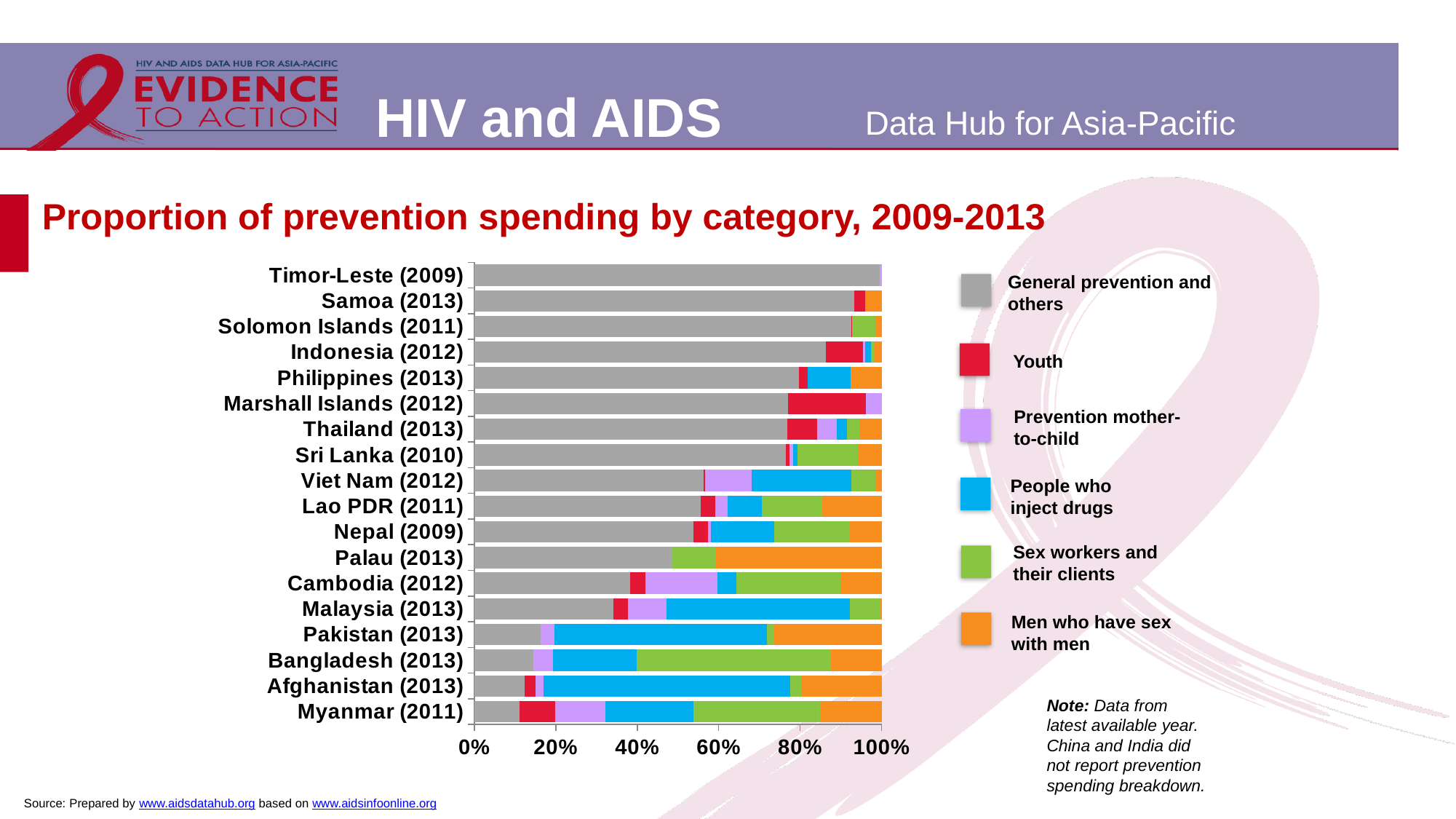
Which country has the smallest share of spending on 'General prevention and others'? Myanmar (2011) What is the title of the chart? Proportion of prevention spending by category, 2009-2013 Which has a larger 'General prevention and others' share, Palau (2013) or Cambodia (2012)? Palau (2013) Is the 'People who inject drugs' share for Afghanistan (2013) greater or less than 40%? greater Is the 'General prevention and others' share for Myanmar (2011) greater or less than 20%? less How many spending categories does the legend list? 6 What kind of chart is shown on the slide? Stacked bar chart Is the 'General prevention and others' share for Timor-Leste (2009) greater or less than 80%? greater Moving down the chart from Timor-Leste to Myanmar, does the 'General prevention and others' share increase or decrease? decrease Which colour represents the 'Youth' category in the legend? Red How many countries (bars) are shown in the chart? 18 Which country has the largest share of spending on 'General prevention and others'? Timor-Leste (2009)